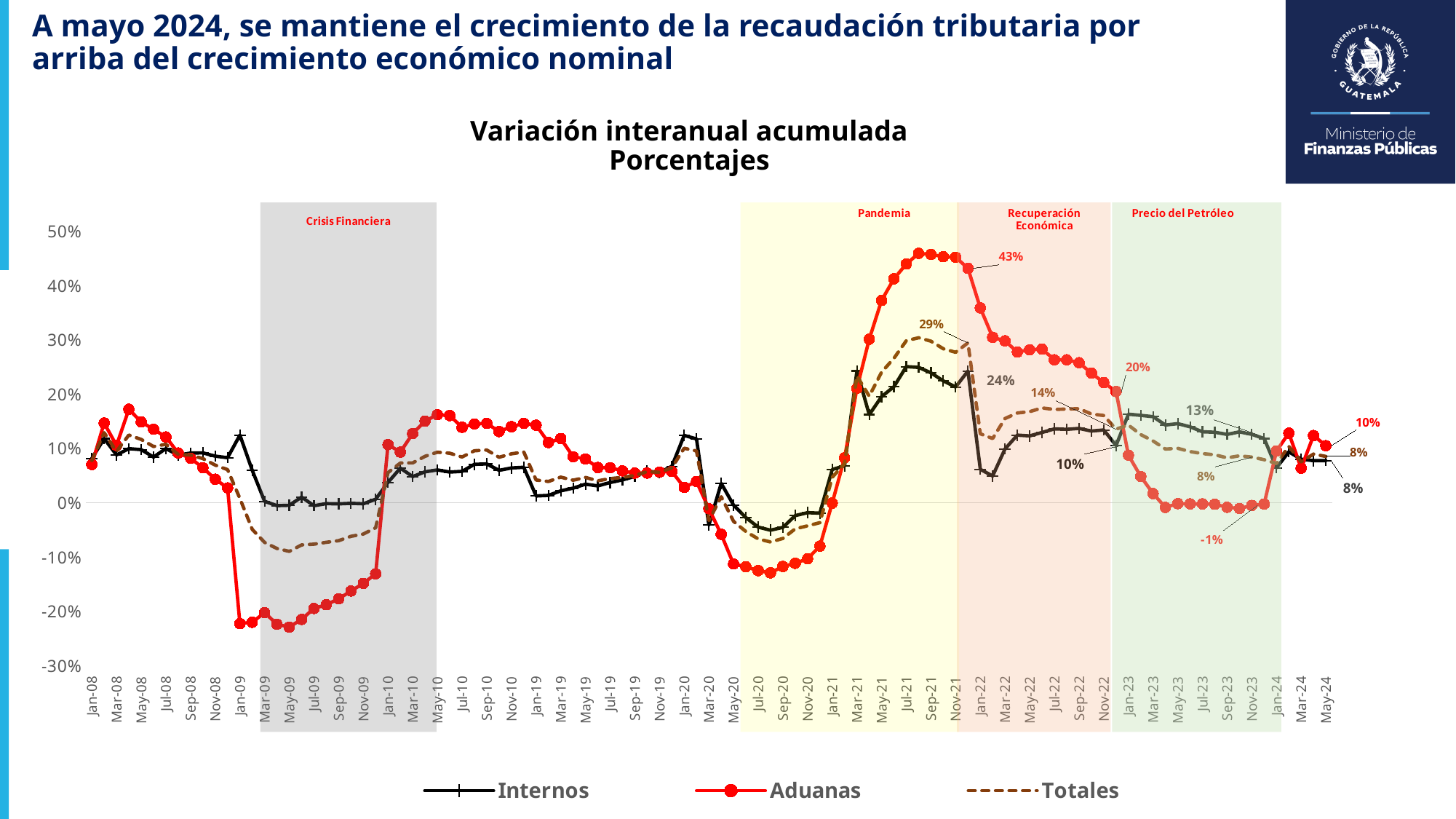
What is the highest data label shown for the Aduanas series? 43% What is the difference between the 43% Aduanas label and the 29% Totales label at the end of 2021? 14 percentage points Is the value for Aduanas around May-09 greater or less than -20%? less Is the value for Aduanas around Sep-21 greater or less than 40%? greater What is the last labelled value (May-24) for the Totales series? 8% What are the three series named in the legend? Internos, Aduanas, Totales At the end of 2021, which labelled value is larger: Aduanas at 43% or Internos at 24%? Aduanas What is the lowest data label shown for the Aduanas series? -1% What kind of chart is shown on the slide? line chart What is the last labelled value (May-24) for the Aduanas series? 10% How many series does the legend list? 3 What is the label of the grey shaded region on the left of the chart? Crisis Financiera